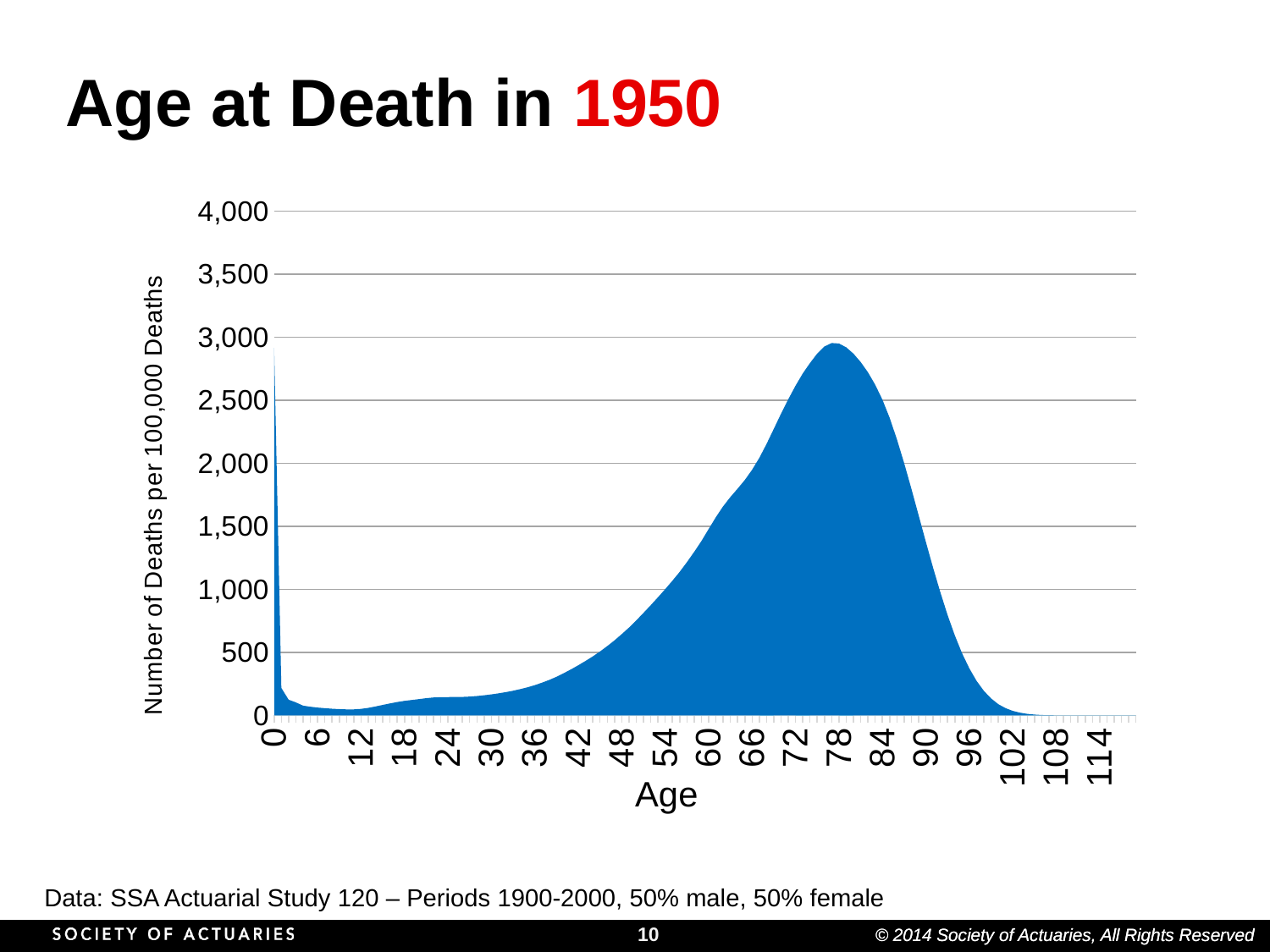
What kind of chart is shown on the slide? area chart Is the value at age 78 greater or less than 2,500? greater Is the value at age 30 greater or less than 500? less Is the value at age 42 greater or less than 500? less What is the title of the chart? Age at Death in 1950 What is the label of the vertical axis? Number of Deaths per 100,000 Deaths Which is larger, the value at age 66 or the value at age 96? age 66 Which is larger, the value at age 78 or the value at age 30? age 78 Do the values rise or fall as age increases from 36 to 78? rise